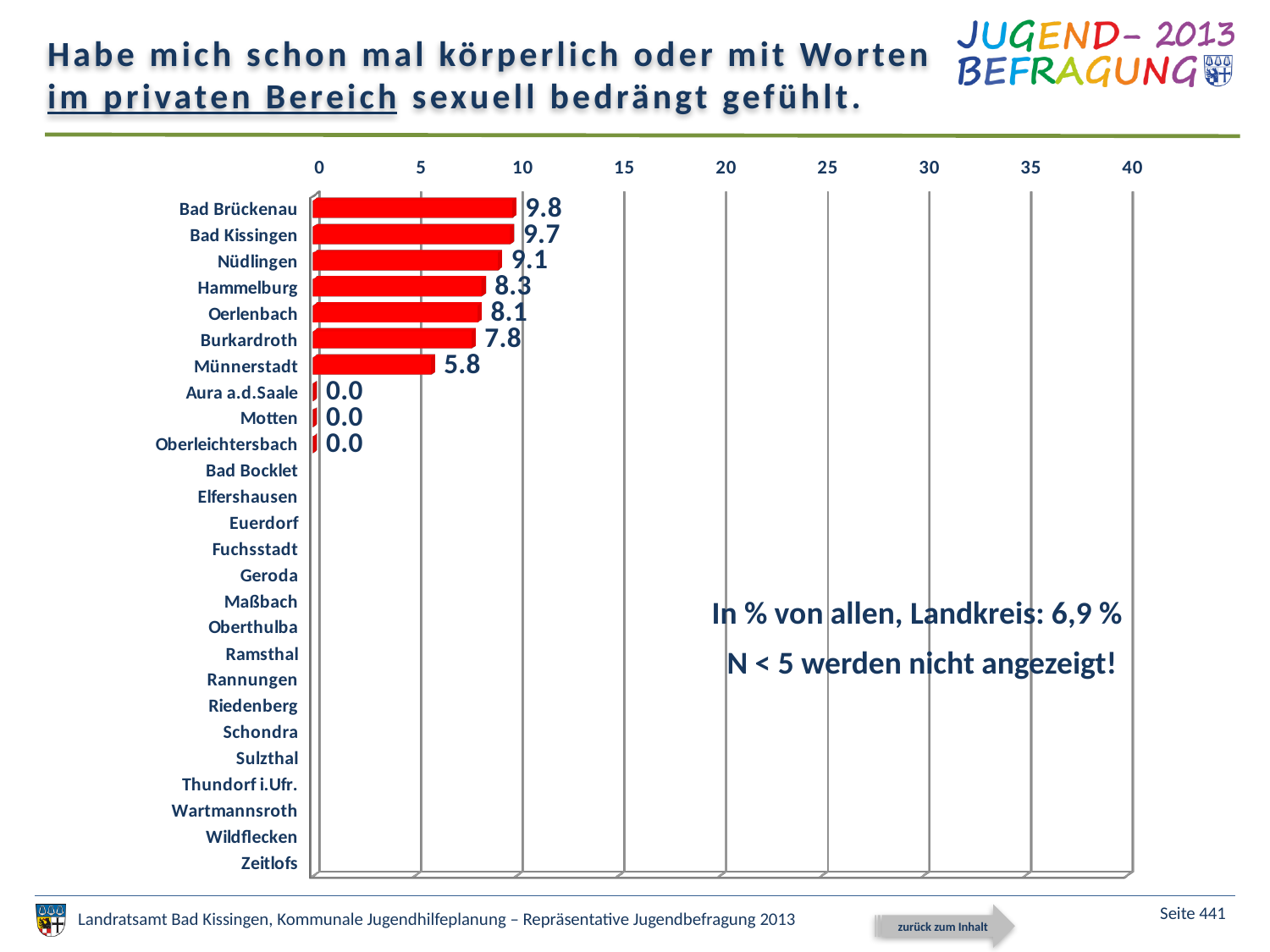
What is the value for Burkardroth? 7.8 How many municipalities are listed on the vertical axis? 26 Which has a larger value, Hammelburg or Oerlenbach? Hammelburg Which municipality has the highest value? Bad Brückenau What is the difference between the values for Bad Brückenau and Münnerstadt? 4.0 What is the value for Bad Brückenau? 9.8 What kind of chart is shown on the slide? bar chart What is the value given for the Landkreis as a whole in the note on the chart? 6,9 % How many municipalities have a data label printed on the chart? 10 What is the value for Nüdlingen? 9.1 Is the value for Münnerstadt greater or less than 5? greater What is the value for Münnerstadt? 5.8